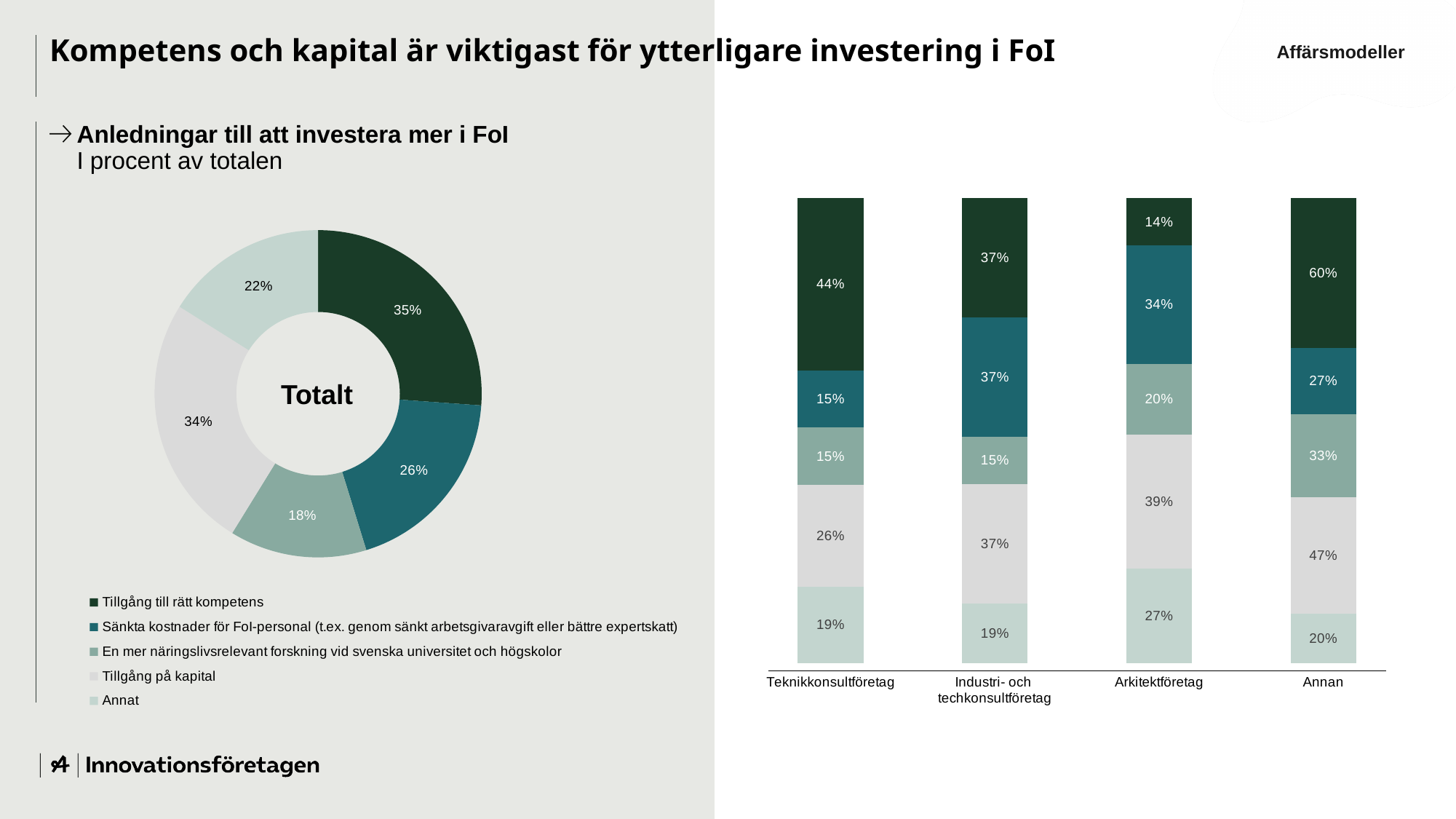
How many entries does the legend on the slide list? 5 On the stacked bar chart on the right, which category has the lowest value for Tillgång till rätt kompetens? Arkitektföretag On the stacked bar chart on the right, what is the value for Tillgång till rätt kompetens for Annan? 60% On the stacked bar chart on the right, what is the value for Tillgång på kapital for Arkitektföretag? 39% How many categories are shown on the x axis of the stacked bar chart on the right? 4 What kind of chart is the chart on the left of the slide? Donut chart On the donut chart on the left, what share is shown for Tillgång på kapital? 34% On the donut chart on the left, what is the difference between the shares for Sänkta kostnader för FoI-personal and Annat? 4% On the donut chart on the left, what share is shown for Tillgång till rätt kompetens? 35% On the donut chart on the left, which category has the smallest share? En mer näringslivsrelevant forskning vid svenska universitet och högskolor On the stacked bar chart on the right, what is the difference between the Tillgång till rätt kompetens values for Teknikkonsultföretag and Industri- och techkonsultföretag? 7% On the stacked bar chart on the right, is the value for Annat larger for Arkitektföretag or for Teknikkonsultföretag? Arkitektföretag